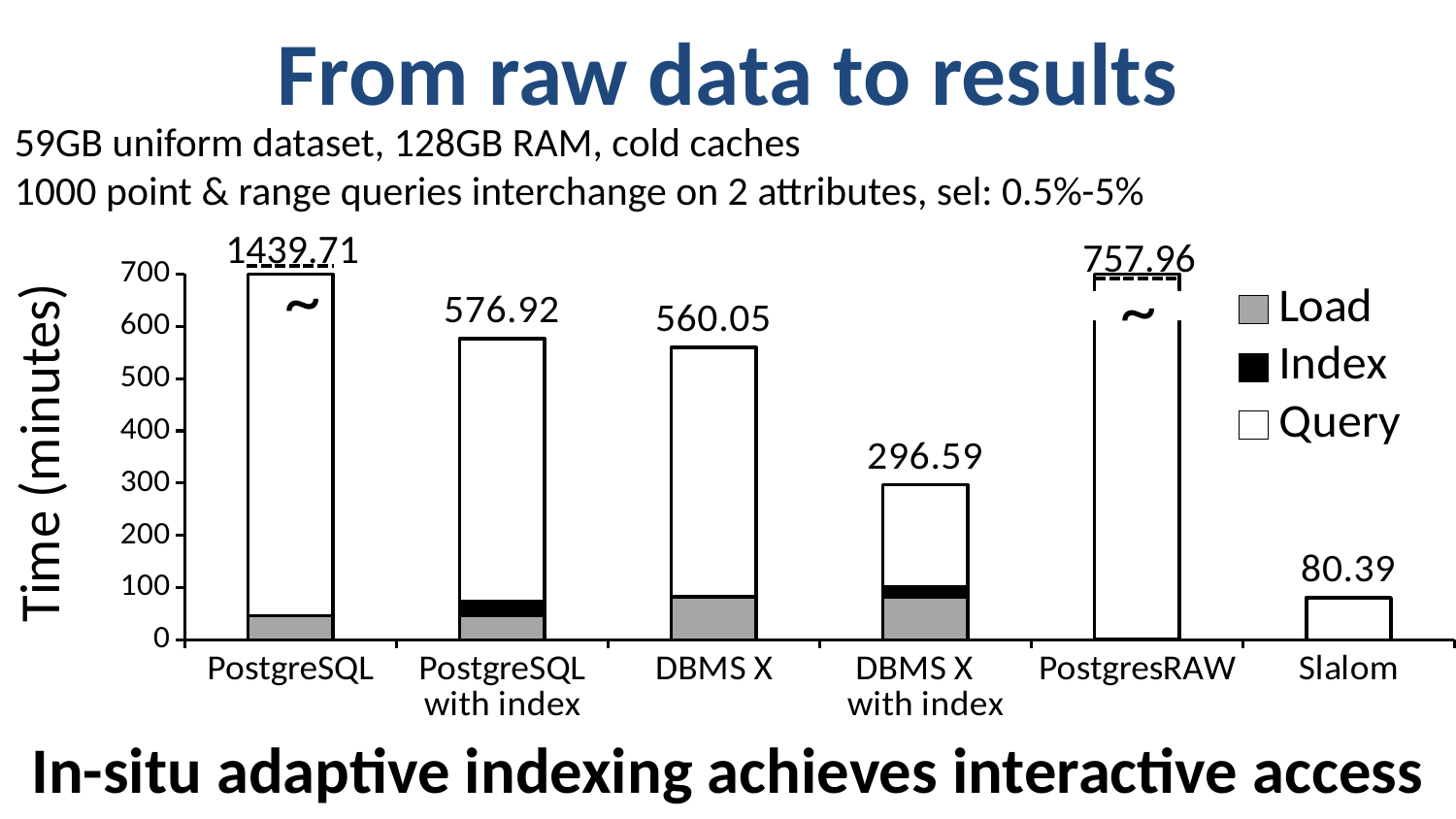
What is the total time in minutes shown for PostgresRAW? 757.96 How many systems are compared on the x axis? 6 Which has a larger total time, DBMS X with index or PostgresRAW? PostgresRAW What kind of chart is shown on the slide? Stacked bar chart What is the total time in minutes shown for DBMS X with index? 296.59 How many series does the legend list? 3 Which system has the lowest total time? Slalom What is the total time in minutes shown for PostgreSQL? 1439.71 What is the difference in total time between PostgreSQL with index and DBMS X? 16.87 What is the total time in minutes shown for Slalom? 80.39 Which system has the highest total time? PostgreSQL What is the difference in total time between PostgresRAW and Slalom? 677.57